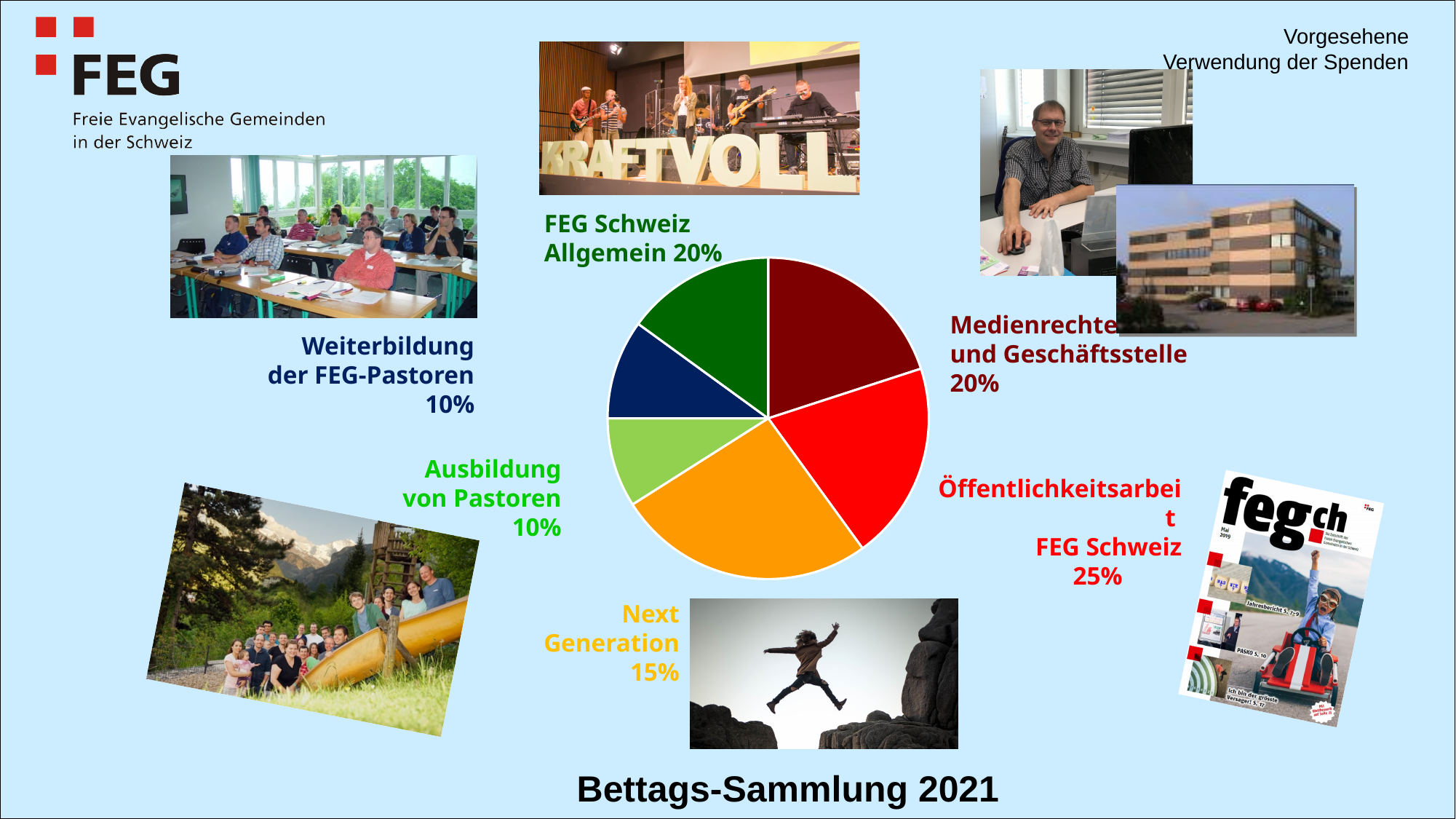
Which category receives the largest share of the pie? Öffentlichkeitsarbeit FEG Schweiz How many slices does the pie chart have? 6 What share of the donations is planned for Ausbildung von Pastoren? 10% Which is larger: the share for FEG Schweiz Allgemein or the share for Weiterbildung der FEG-Pastoren? FEG Schweiz Allgemein What share of the donations is planned for Medienrechte und Geschäftsstelle? 20% What colour is the slice for Next Generation? orange What kind of chart is shown on the slide? pie chart What is the title shown at the bottom of the slide? Bettags-Sammlung 2021 What is the combined share of Ausbildung von Pastoren and Weiterbildung der FEG-Pastoren? 20% What share of the donations is planned for Öffentlichkeitsarbeit FEG Schweiz? 25% What is the difference between the share for Öffentlichkeitsarbeit FEG Schweiz and the share for Next Generation? 10% What share of the donations is planned for Next Generation? 15%